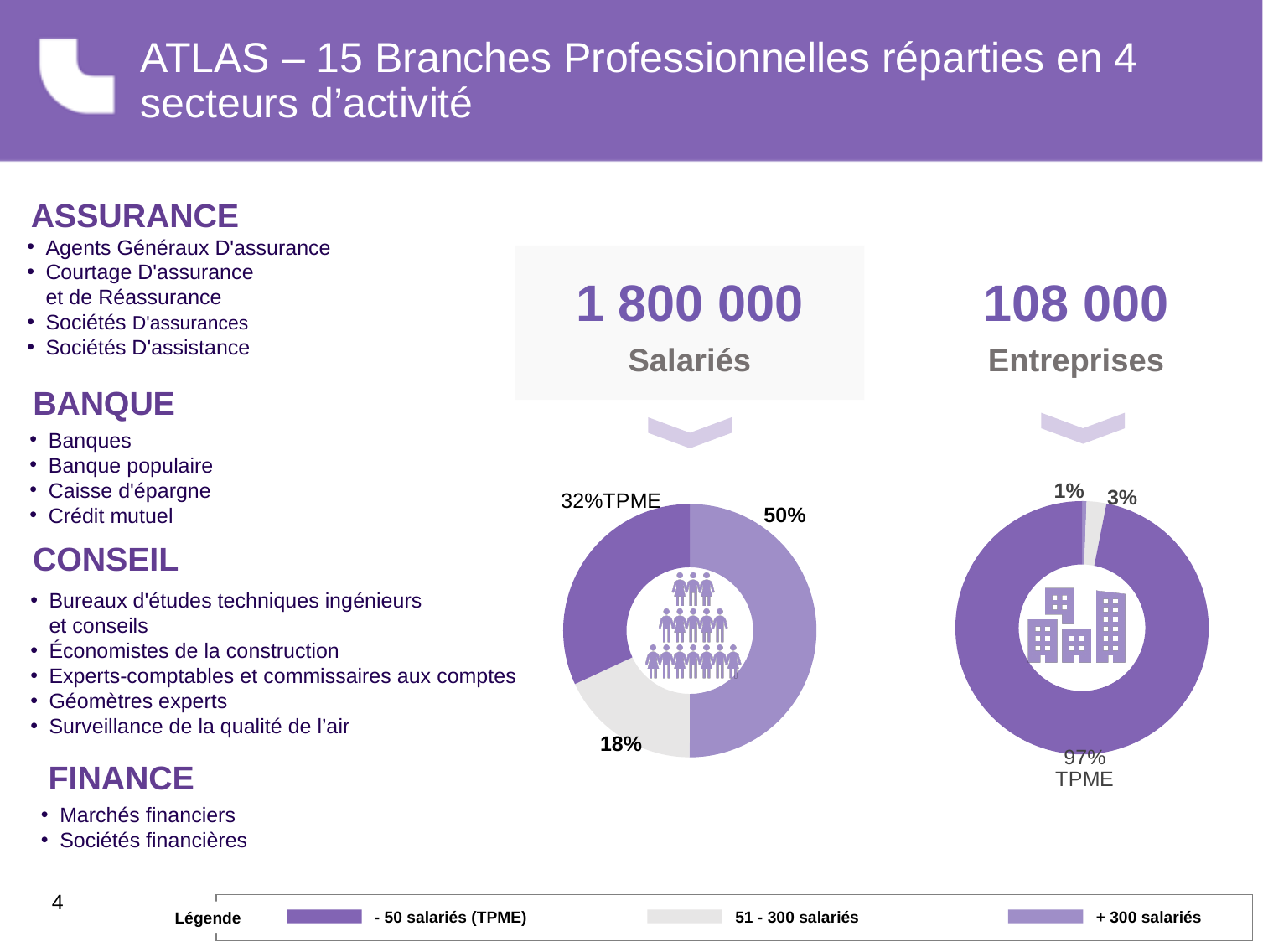
In the Salariés donut chart, what share of employees work in companies with fewer than 50 employees (TPME)? 32% What type of chart is used to show the Salariés and Entreprises breakdowns? Donut (pie) chart In the Salariés donut chart, what share of employees work in companies with more than 300 employees? 50% In the Salariés donut chart, what share of employees work in companies with 51 to 300 employees? 18% In the Entreprises donut chart, which category has the smallest share? + 300 salariés In the Salariés donut chart, what is the difference between the share for + 300 salariés and the share for - 50 salariés (TPME)? 18% In the Salariés donut chart, which is larger: the share for 51 - 300 salariés or the share for - 50 salariés (TPME)? - 50 salariés (TPME) In the Entreprises donut chart, what share of companies are TPME (fewer than 50 employees)? 97% In the Entreprises donut chart, what share of companies have more than 300 employees? 1% In the Salariés donut chart, which category has the largest share? + 300 salariés How many categories does the legend at the bottom of the slide list? 3 In the Entreprises donut chart, what is the difference between the TPME share and the + 300 salariés share? 96%